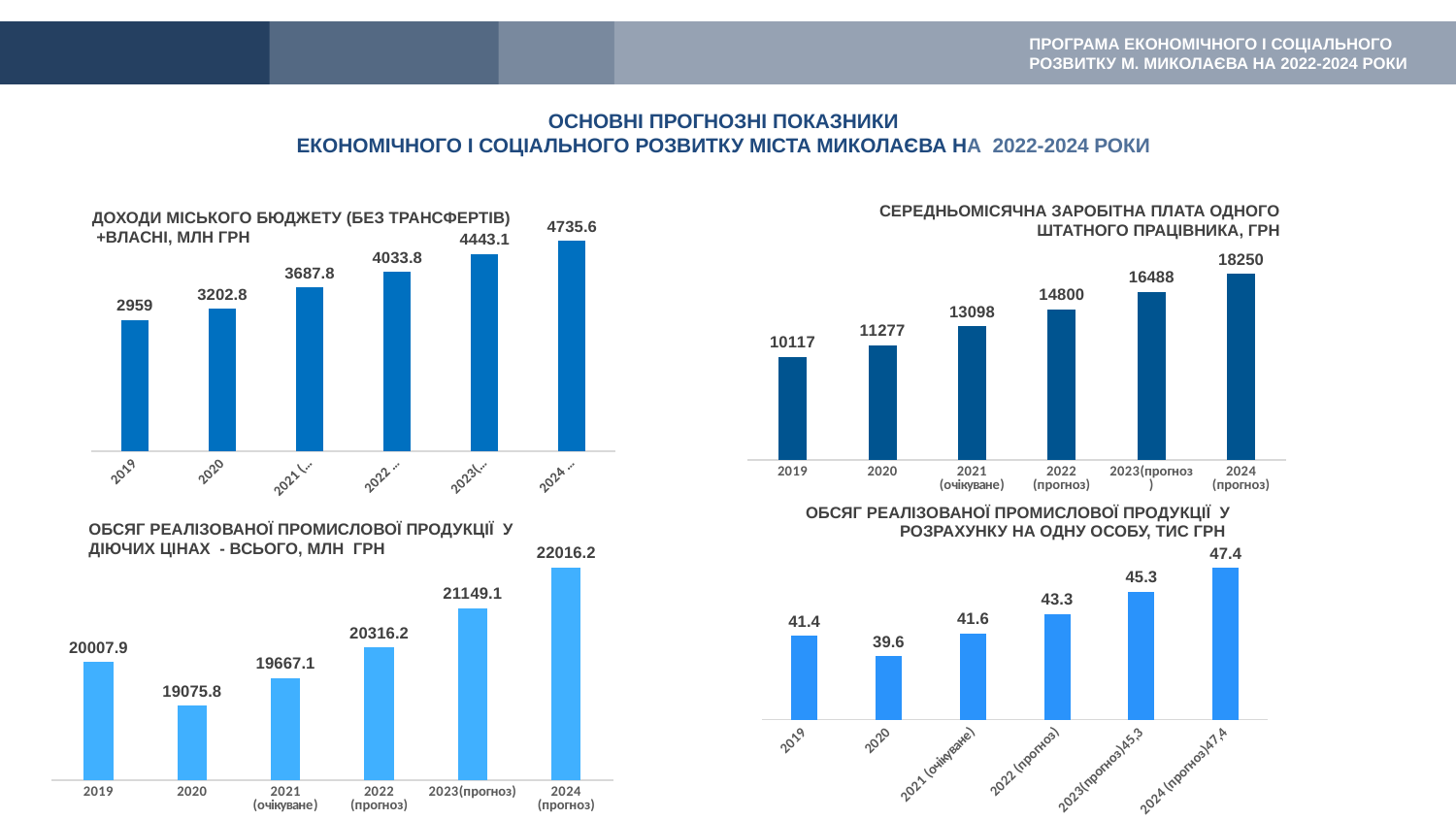
In the bottom-right chart (Обсяг реалізованої промислової продукції у розрахунку на одну особу), what is the value for 2020? 39.6 In the bottom-left chart (Обсяг реалізованої промислової продукції у діючих цінах), which year has the lowest value? 2020 In the top-left chart (Доходи міського бюджету), what is the value for the last bar, 2024? 4735.6 In the top-left chart (Доходи міського бюджету), what is the value for 2019? 2959 In the top-right chart (Середньомісячна заробітна плата), what is the difference between the 2024 (прогноз) and 2019 values? 8133 In the bottom-left chart (Обсяг реалізованої промислової продукції у діючих цінах), which is larger: the value for 2019 or the value for 2021 (очікуване)? 2019 In the bottom-right chart (Обсяг реалізованої промислової продукції у розрахунку на одну особу), what is the difference between the 2024 and 2023 values? 2.1 What type of chart is the top-right chart (Середньомісячна заробітна плата)? Bar chart In the top-right chart (Середньомісячна заробітна плата), which year has the highest value? 2024 (прогноз) In the bottom-left chart (Обсяг реалізованої промислової продукції у діючих цінах), what is the value for 2023(прогноз)? 21149.1 How many bars does the top-left chart (Доходи міського бюджету) have? 6 In the top-right chart (Середньомісячна заробітна плата), what is the value for 2022 (прогноз)? 14800